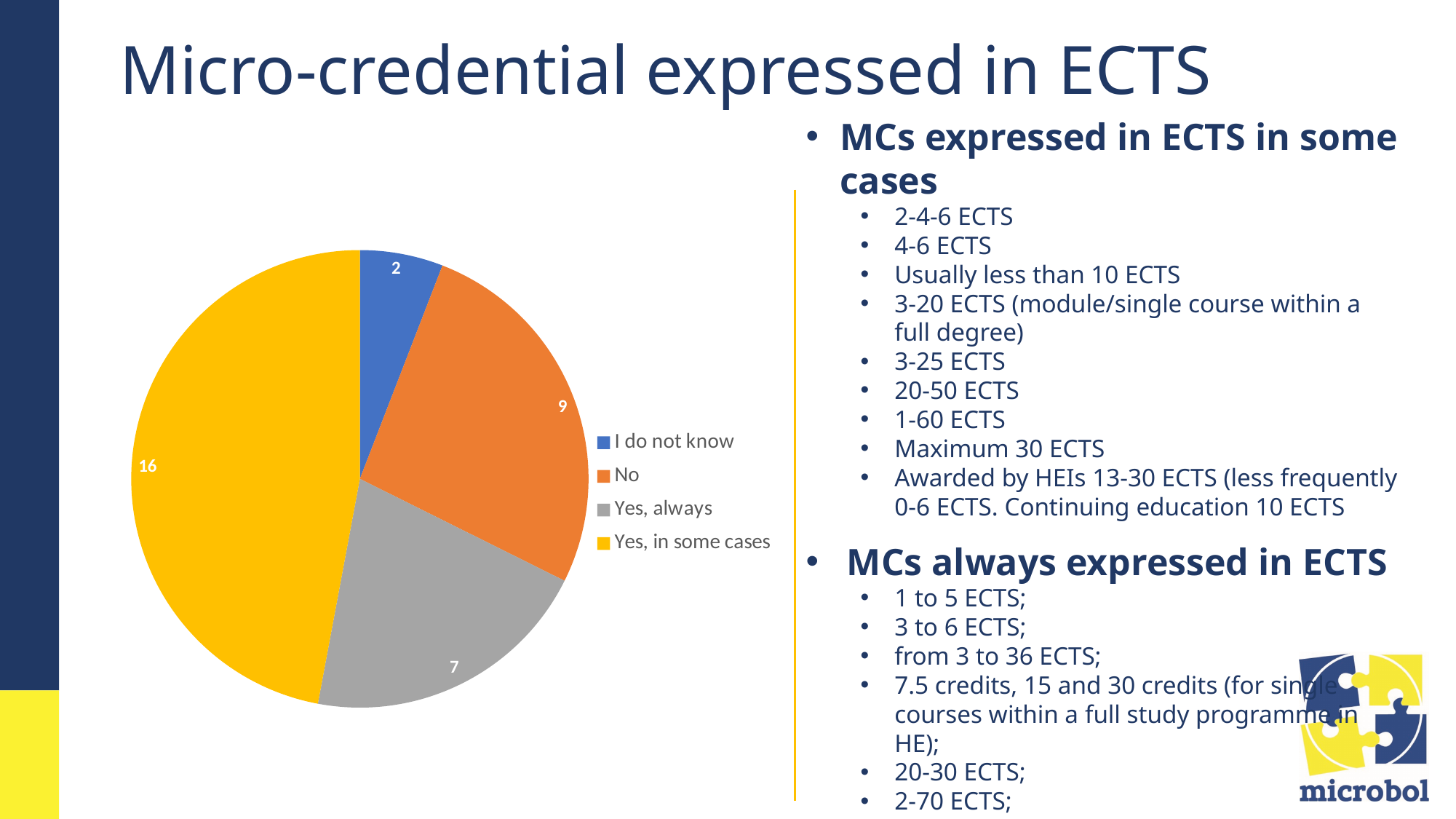
Which category has the smallest slice in the pie chart? I do not know What type of chart is shown on the slide? pie chart What is the value for "Yes, in some cases" in the pie chart? 16 What colour is the "Yes, in some cases" slice in the pie chart? yellow What is the value for "No" in the pie chart? 9 Which category has the largest slice in the pie chart? Yes, in some cases What is the value for "Yes, always" in the pie chart? 7 What is the total of all the values shown in the pie chart? 34 Which is larger in the pie chart, "No" or "Yes, always"? No What is the difference between the values for "Yes, in some cases" and "No"? 7 How many slices does the pie chart have? 4 What is the value for "I do not know" in the pie chart? 2